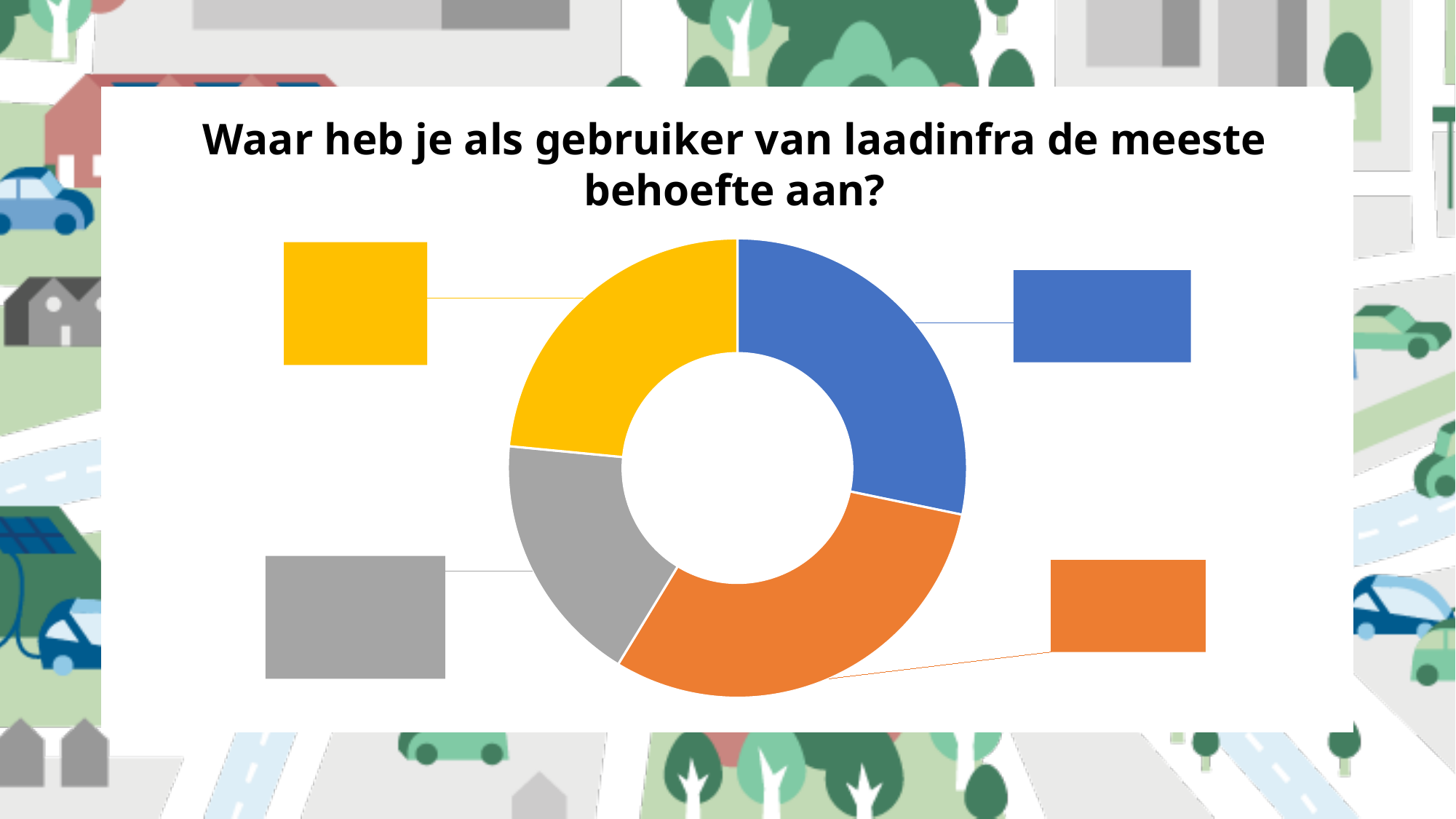
Which is larger in the doughnut chart, the orange slice or the grey slice? Orange How many slices does the doughnut chart have? 4 What is the title of the chart on the slide? Waar heb je als gebruiker van laadinfra de meeste behoefte aan? What kind of chart is shown on the slide? Doughnut (pie) chart Which colour slice is the smallest in the doughnut chart? Grey Which is larger in the doughnut chart, the blue slice or the yellow slice? Blue Which is larger in the doughnut chart, the blue slice or the grey slice? Blue What colours are the four slices of the doughnut chart? Blue, orange, grey and yellow